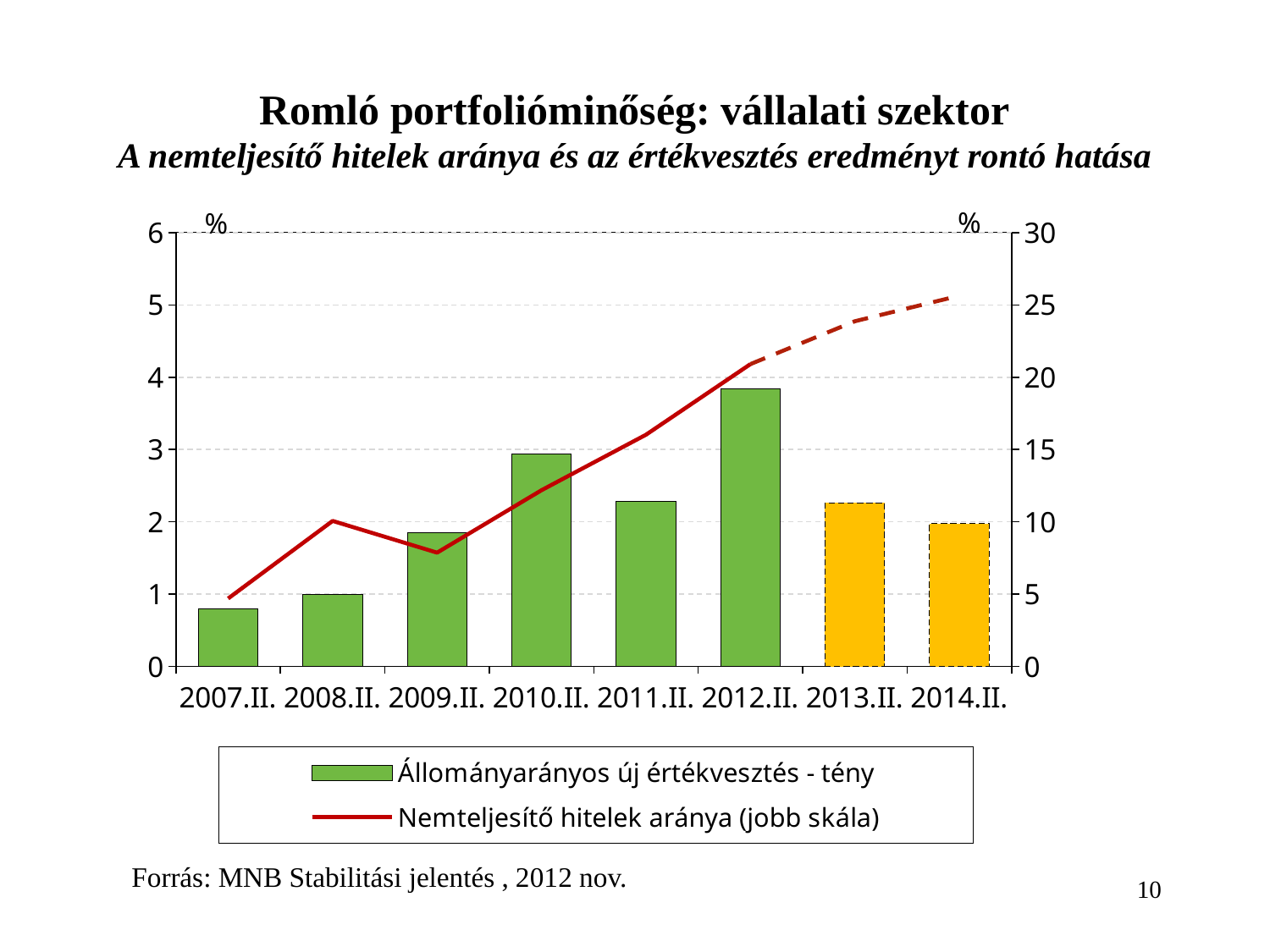
In which period is the bar for 'Állományarányos új értékvesztés - tény' the highest? 2012.II. Is the 'Nemteljesítő hitelek aránya' line value for 2009.II. greater or less than 10 on the right axis? less How many time periods are shown on the x axis of the chart? 8 Is the bar value for 2012.II. greater or less than 3 on the left axis? greater Is the 'Nemteljesítő hitelek aránya' line value for 2012.II. greater or less than 20 on the right axis? greater Does the 'Nemteljesítő hitelek aránya' line generally rise or fall from 2009.II. to 2014.II.? rise In which period is the bar for 'Állományarányos új értékvesztés - tény' the lowest? 2007.II. How many series does the chart legend list? 2 What kind of chart is shown on the slide? A combined bar and line chart Which series is plotted on the right-hand scale according to the legend? Nemteljesítő hitelek aránya (jobb skála) Which bar is taller, 2010.II. or 2011.II.? 2010.II.